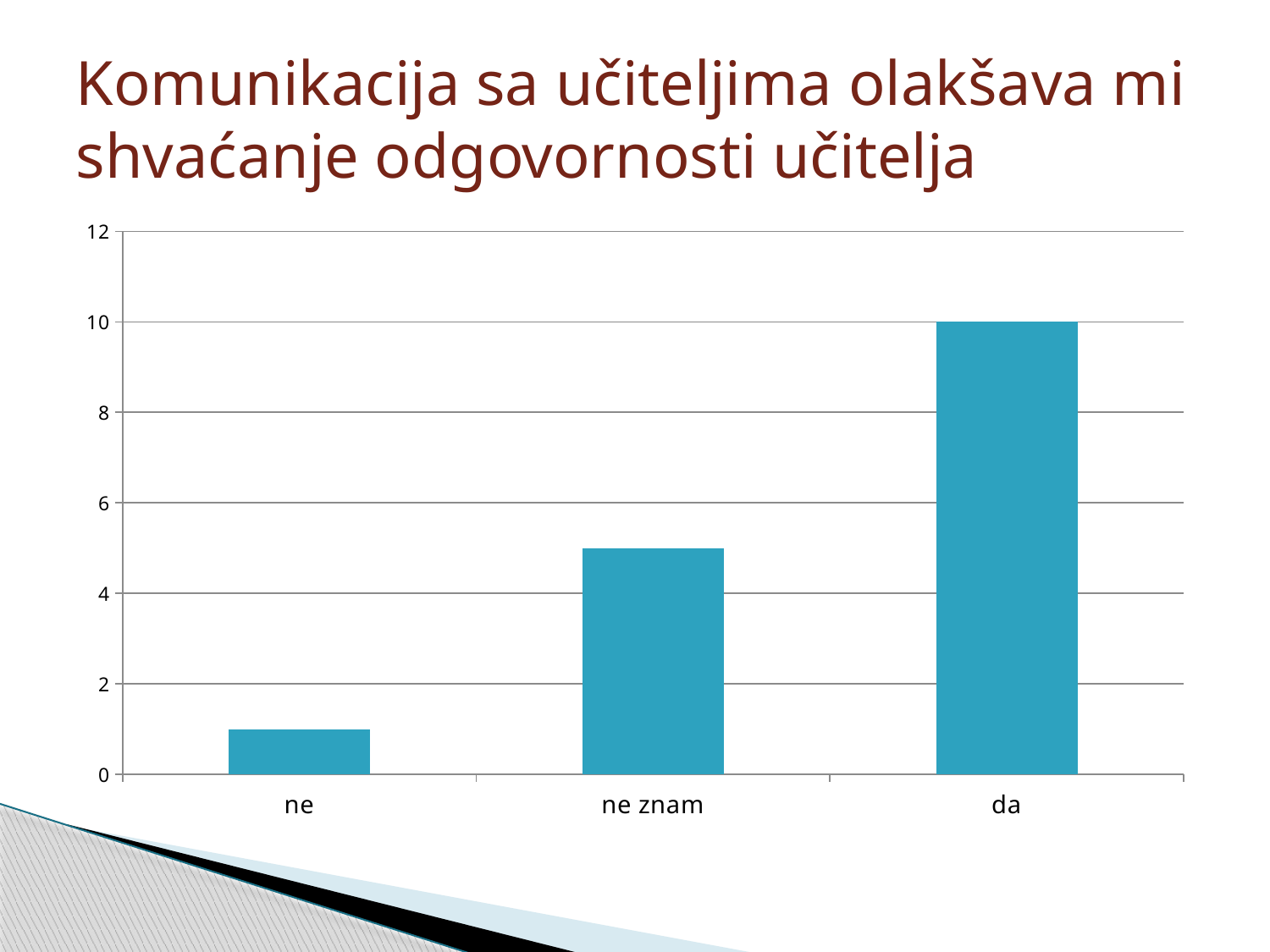
Which category has the highest bar in the chart? da Which category has the lowest bar in the chart? ne What is the highest value shown on the vertical axis of the chart? 12 Is the value for "ne znam" greater or less than 6? less Which is larger, the value for "ne znam" or the value for "da"? da What type of chart is shown on the slide? bar chart Is the value for "ne znam" greater or less than 4? greater How many categories are shown on the x axis of the chart? 3 Do the bar values rise or fall from left to right along the x axis? rise Is the value for "ne" greater or less than 2? less What is the value for "da" in the chart? 10 Which is larger, the value for "ne" or the value for "ne znam"? ne znam